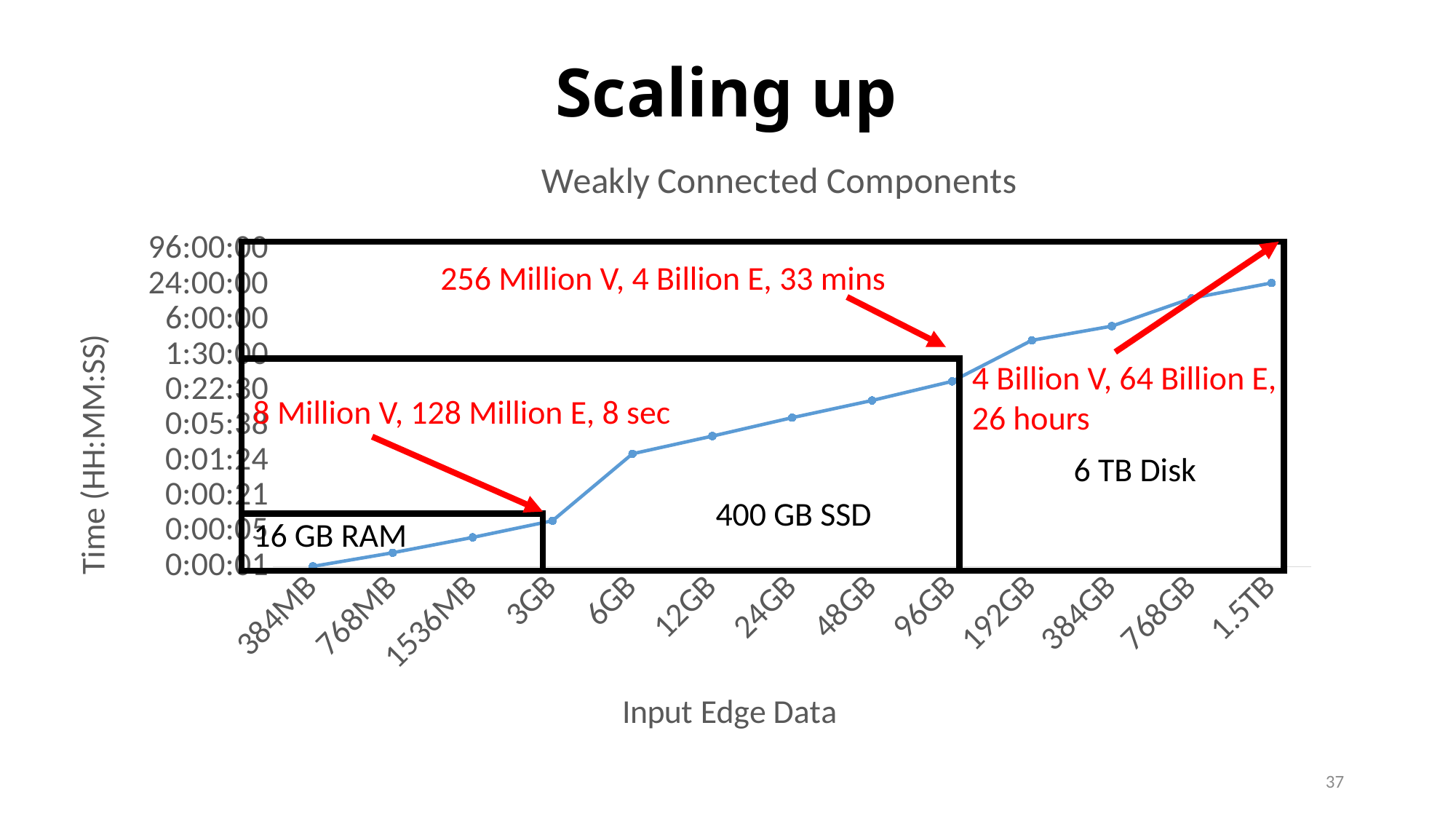
How many data points are plotted on the line? 13 Which input edge data size has the lowest time? 384MB According to the annotation, how long did the run with 8 Million V, 128 Million E take? 8 sec According to the annotation, how long did the run with 256 Million V, 4 Billion E take? 33 mins Is the time for 12GB greater or less than 0:01:24? greater According to the annotation, how long did the run with 4 Billion V, 64 Billion E take? 26 hours What kind of chart is shown on the slide? line chart Which input edge data size has the highest time? 1.5TB What is the title of the x axis? Input Edge Data Do the time values rise or fall as the input edge data increases along the x axis? rise Is the time for 192GB greater or less than 1:30:00? greater Which has a larger time, 96GB or 3GB? 96GB